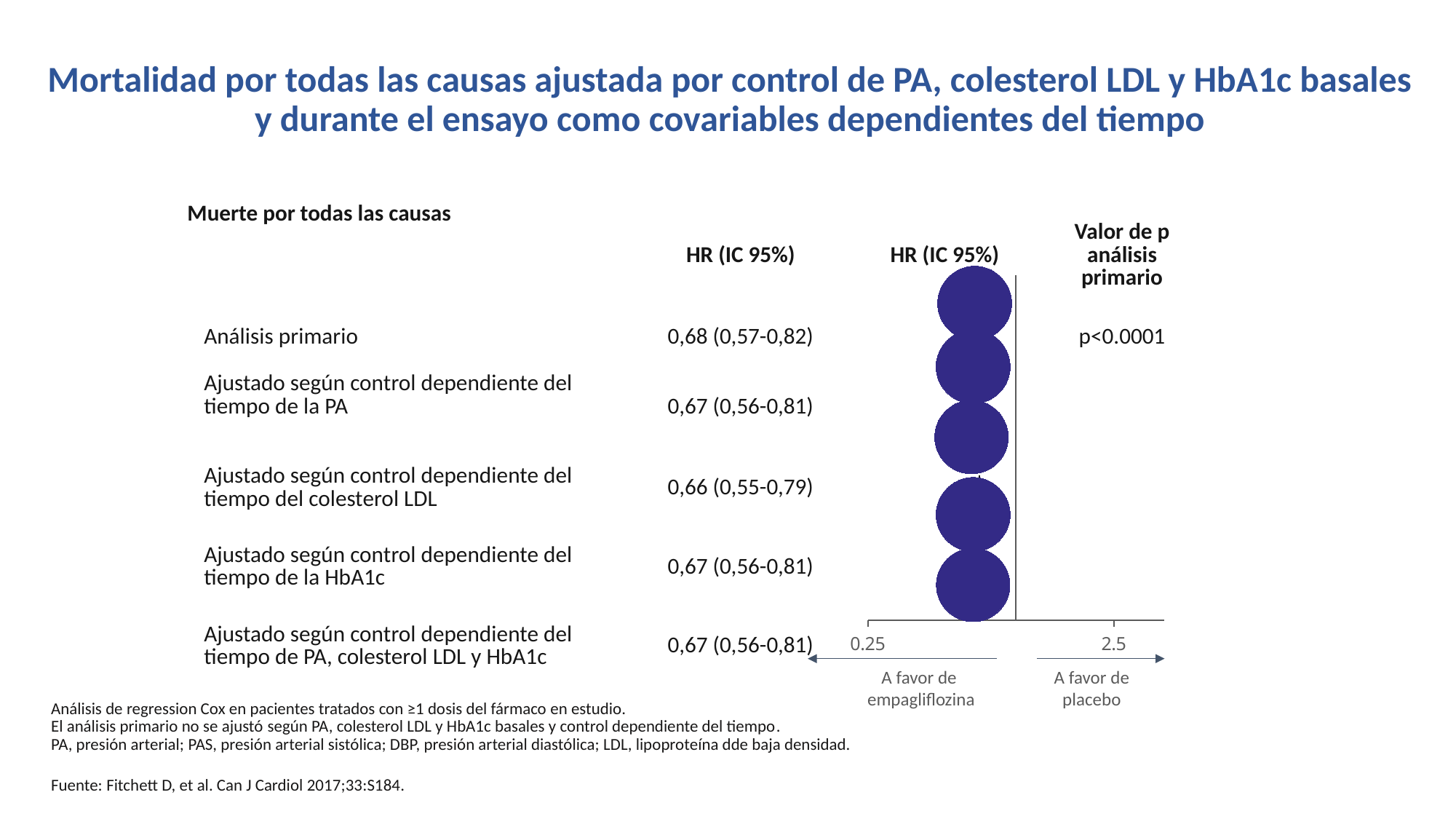
Which side of the forest plot axis is labelled 'A favor de placebo'? The right side How many analyses are plotted in the forest plot? 5 Is the HR for the Análisis primario greater or less than 2.5? less What is the difference between the HR of the Análisis primario and the HR of the analysis adjusted for LDL cholesterol control? 0,02 What is the HR (IC 95%) for the Análisis primario? 0,68 (0,57-0,82) Which analysis has the highest HR point estimate? Análisis primario What is the HR (IC 95%) for the analysis adjusted for time-dependent control of PA, colesterol LDL y HbA1c? 0,67 (0,56-0,81) Which analysis has the lowest HR point estimate? Ajustado según control dependiente del tiempo del colesterol LDL Which has a larger HR: the Análisis primario or the analysis adjusted for time-dependent control of HbA1c? Análisis primario What p-value is shown for the Análisis primario? p<0.0001 What is the HR (IC 95%) for the analysis adjusted for time-dependent control of LDL cholesterol (Ajustado según control dependiente del tiempo del colesterol LDL)? 0,66 (0,55-0,79) What kind of chart is shown on the slide? Forest plot